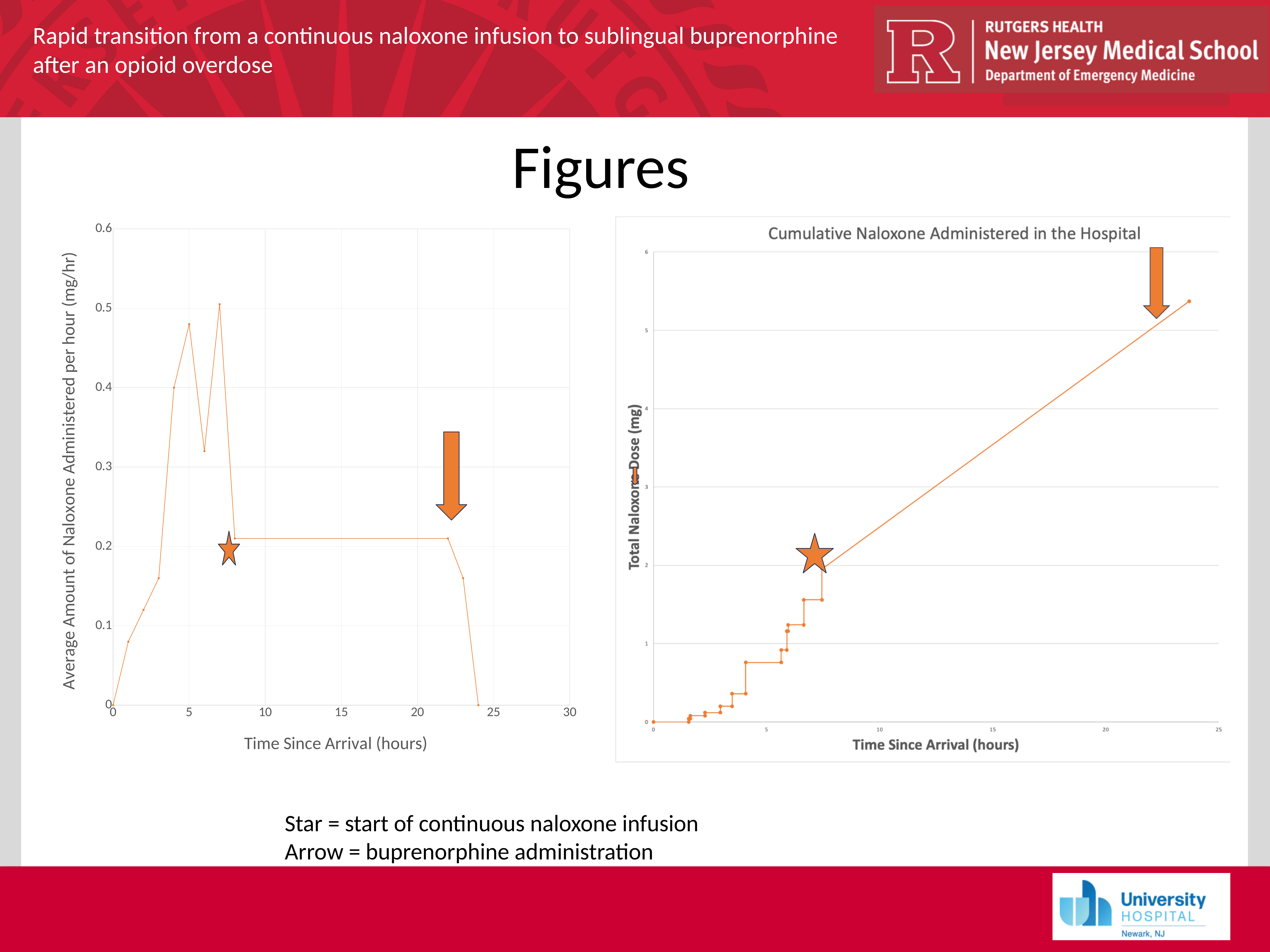
In the chart on the left of the slide, what is the value at 24 hours since arrival? 0 In the chart titled 'Cumulative Naloxone Administered in the Hospital', is the value at 15 hours since arrival greater or less than 3? greater In the chart on the left of the slide, is the value during the flat section between 10 and 20 hours since arrival greater or less than 0.3? less In the chart titled 'Cumulative Naloxone Administered in the Hospital', do the values rise or fall as time since arrival increases? rise What is the title of the chart on the right of the slide? Cumulative Naloxone Administered in the Hospital What kind of chart is the chart titled 'Cumulative Naloxone Administered in the Hospital'? line chart What is the y-axis label of the chart on the left of the slide? Average Amount of Naloxone Administered per hour (mg/hr) In the chart on the left of the slide, is the value at 5 hours since arrival greater or less than 0.4? greater What kind of chart is the chart on the left of the slide? line chart